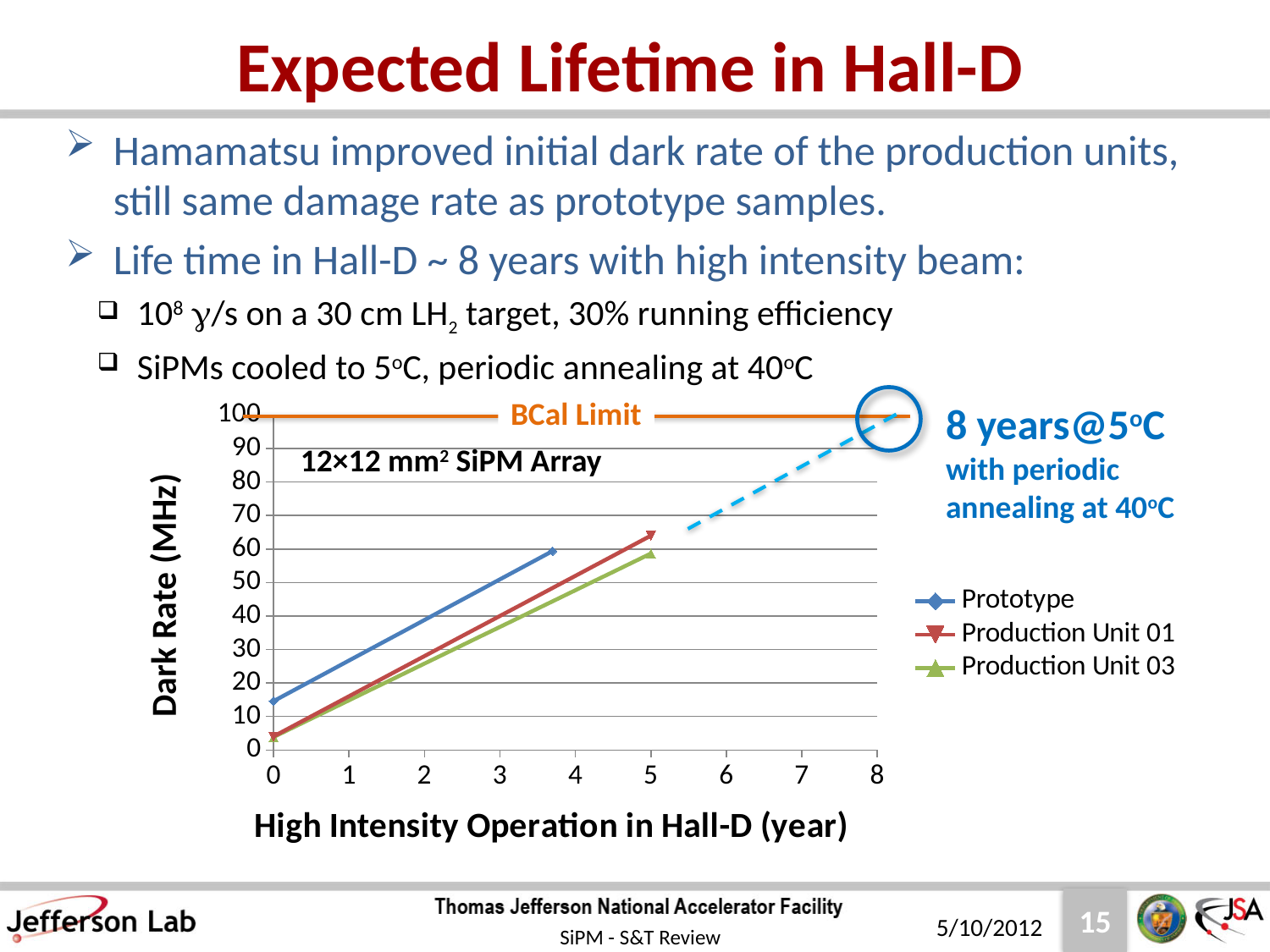
Is the dark rate for Production Unit 01 at year 0 greater or less than 10 MHz? less Is the dark rate for Production Unit 01 at year 5 greater or less than 50 MHz? greater Is the dark rate for the Prototype series at year 0 greater or less than 10 MHz? greater Does the dark rate for Production Unit 03 rise or fall along the x axis? rise What kind of chart is shown on the slide? line chart Which series are listed in the chart legend? Prototype, Production Unit 01, Production Unit 03 Does the dark rate for the Prototype series rise or fall as the years of high intensity operation increase? rise How many series does the chart legend list? 3 What is the title of the chart's y axis? Dark Rate (MHz) At year 5, which series has the higher dark rate, Production Unit 01 or Production Unit 03? Production Unit 01 At year 0, which series has the higher dark rate, Prototype or Production Unit 01? Prototype